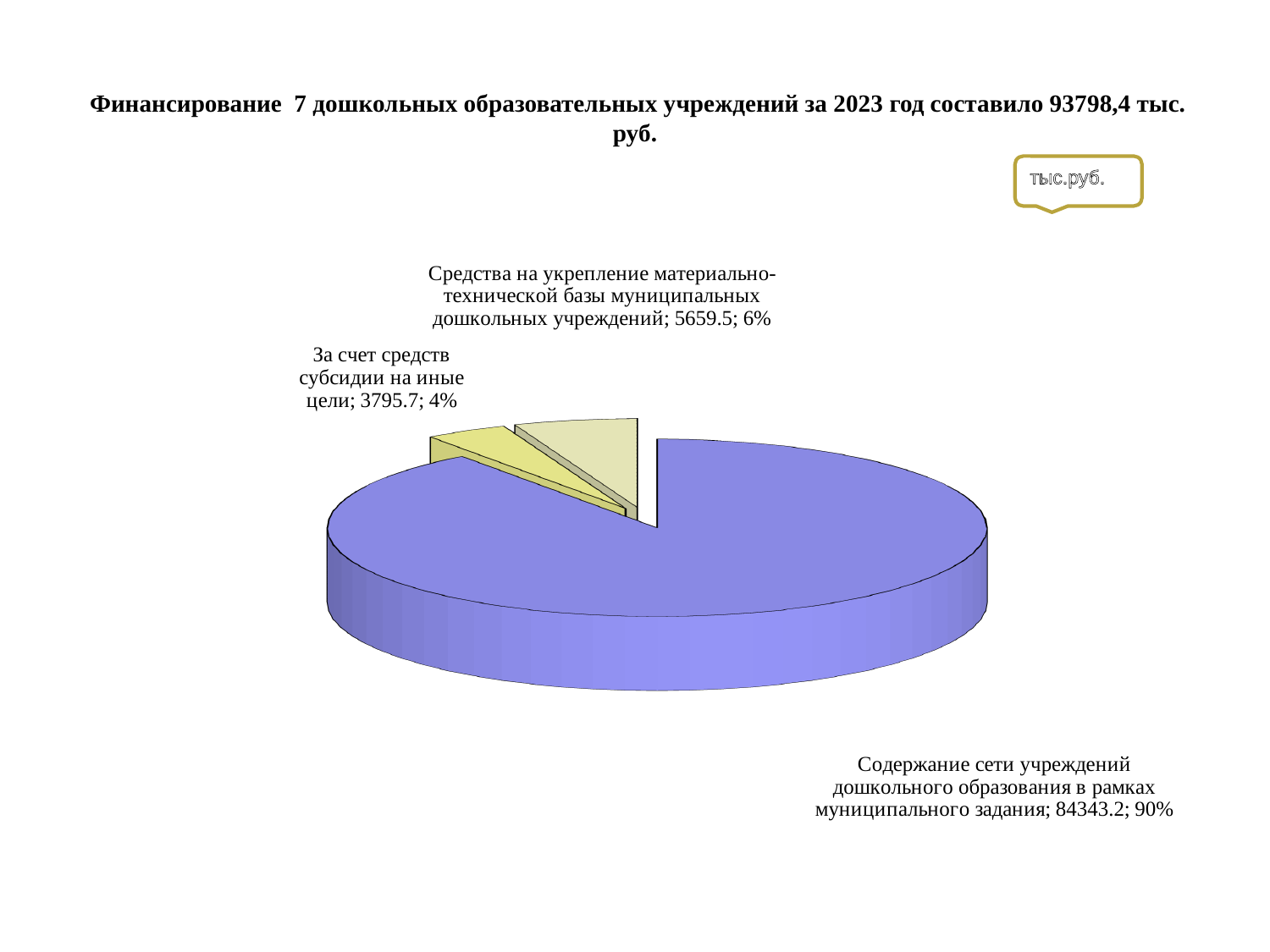
What is the value for "За счет средств субсидии на иные цели"? 3795.7 What is the value for "Содержание сети учреждений дошкольного образования в рамках муниципального задания"? 84343.2 How many slices does the pie chart have? 3 Which is larger: "Средства на укрепление материально-технической базы муниципальных дошкольных учреждений" or "За счет средств субсидии на иные цели"? Средства на укрепление материально-технической базы муниципальных дошкольных учреждений Which category has the largest slice of the pie? Содержание сети учреждений дошкольного образования в рамках муниципального задания Which category has the smallest slice of the pie? За счет средств субсидии на иные цели What share of the pie does "За счет средств субсидии на иные цели" represent? 4% What share of the pie does "Средства на укрепление материально-технической базы муниципальных дошкольных учреждений" represent? 6% What is the difference between the values for "Средства на укрепление материально-технической базы муниципальных дошкольных учреждений" and "За счет средств субсидии на иные цели"? 1863.8 What share of the pie does "Содержание сети учреждений дошкольного образования в рамках муниципального задания" represent? 90% What is the value for "Средства на укрепление материально-технической базы муниципальных дошкольных учреждений"? 5659.5 What kind of chart is shown on the slide? Pie chart